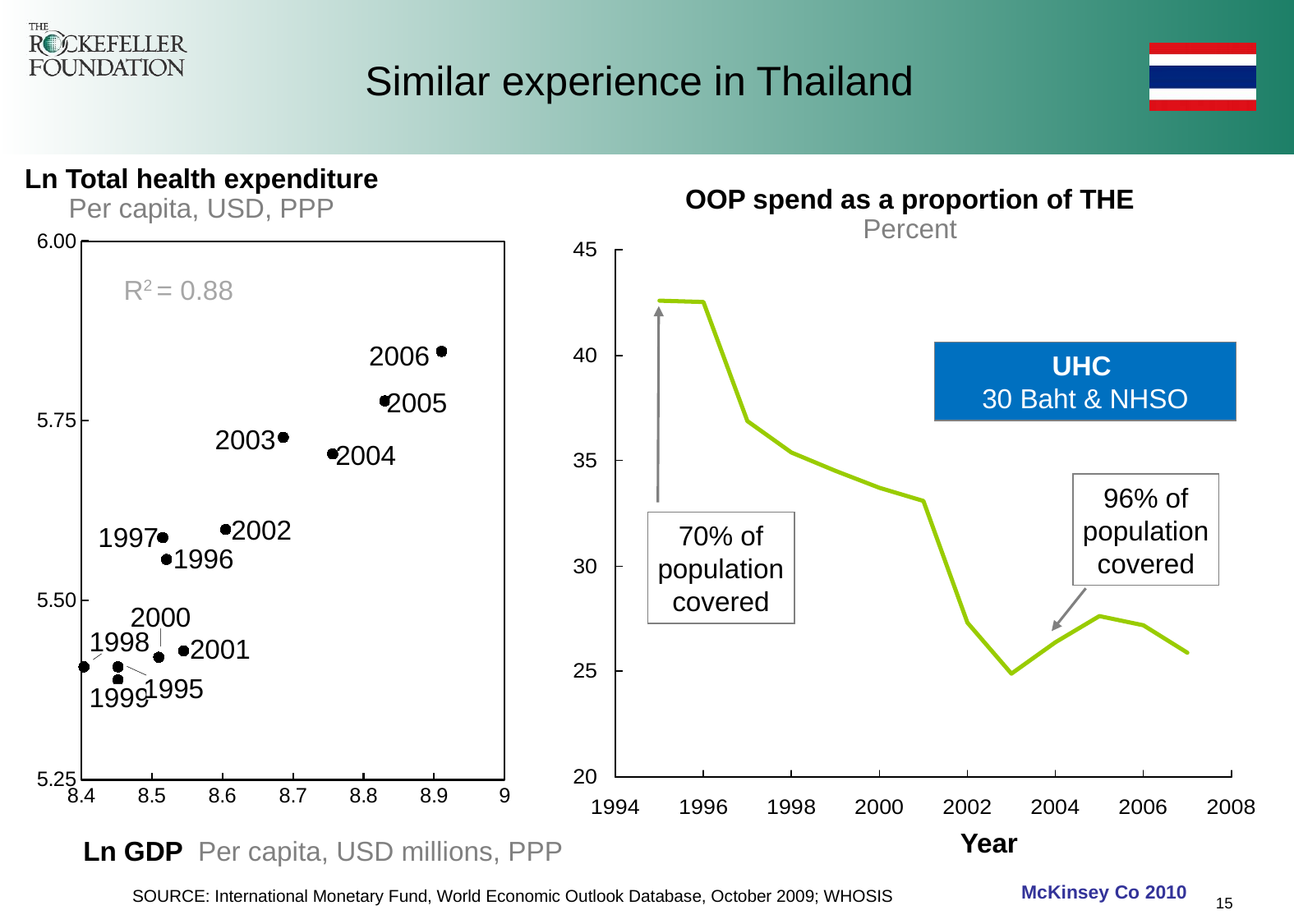
In the left chart (Ln Total health expenditure), what R-squared value is shown? R² = 0.88 In the right chart (OOP spend as a proportion of THE), which year has the lowest value? 2003 What type of chart is the left chart (Ln Total health expenditure)? Scatter plot In the left chart (Ln Total health expenditure), is the value for 1996 greater or less than 5.50? greater In the right chart (OOP spend as a proportion of THE), is the value for 1995 greater or less than 40? greater In the left chart (Ln Total health expenditure), how many data points are plotted? 12 In the left chart (Ln Total health expenditure), which year has the highest Ln Total health expenditure per capita? 2006 In the right chart (OOP spend as a proportion of THE), is the value for 2007 greater or less than 30? less In the left chart (Ln Total health expenditure), which year has the higher Ln Total health expenditure, 2003 or 2002? 2003 In the right chart (OOP spend as a proportion of THE), do the values generally rise or fall from 1995 to 2007? Fall